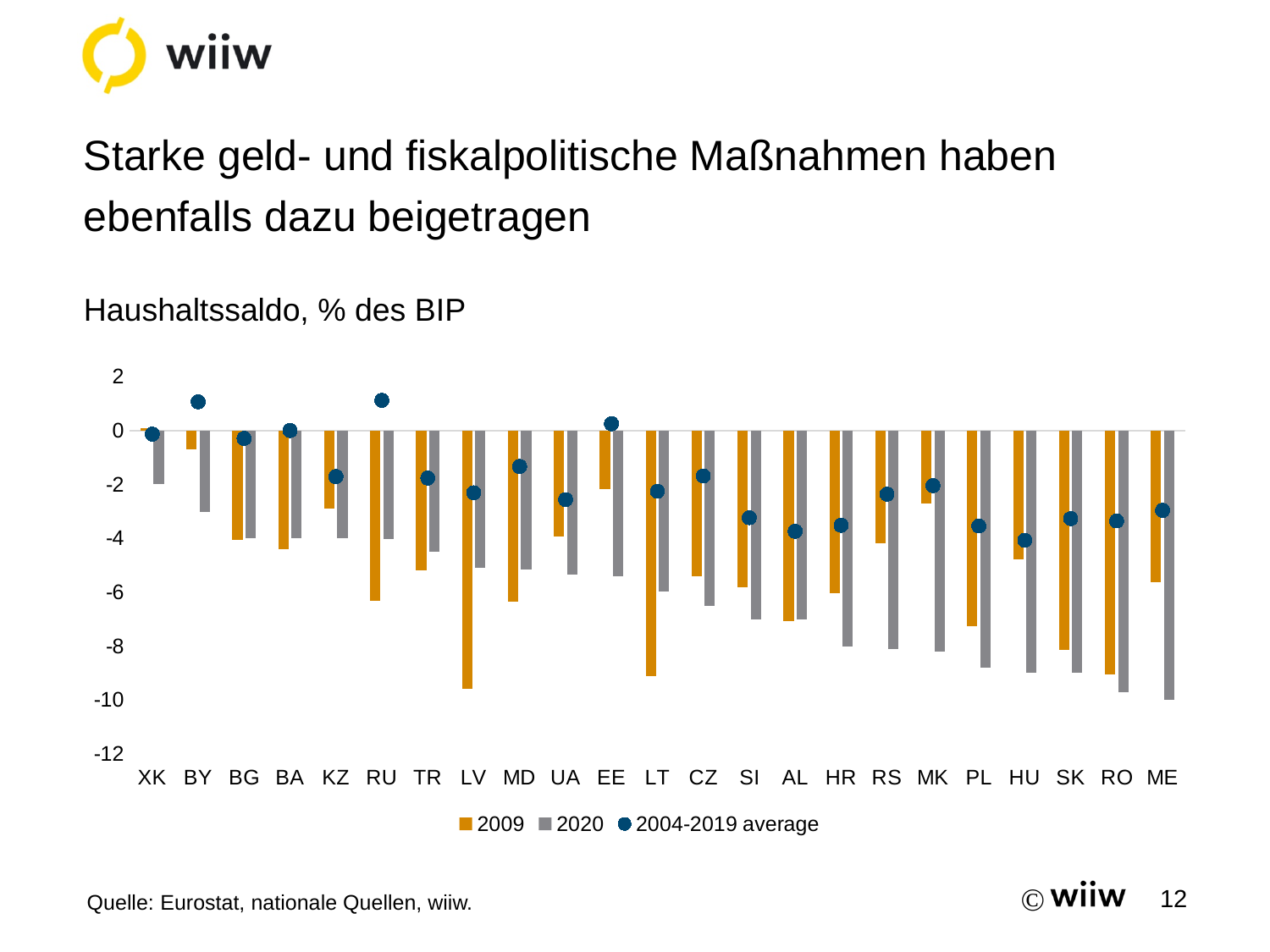
Is the 2009 value for BY greater or less than -2? greater What is the title of the chart? Haushaltssaldo, % des BIP What kind of chart is shown on the slide? bar chart with markers Is the 2004-2019 average for RU greater or less than 0? greater For HU, which is larger, the 2009 value or the 2020 value? 2009 Is the 2020 value for ME greater or less than -8? less How many countries are shown on the x axis of the chart? 23 Which series is shown as blue dots in the chart? 2004-2019 average Which country has the highest 2020 value? XK How many series does the chart legend list? 3